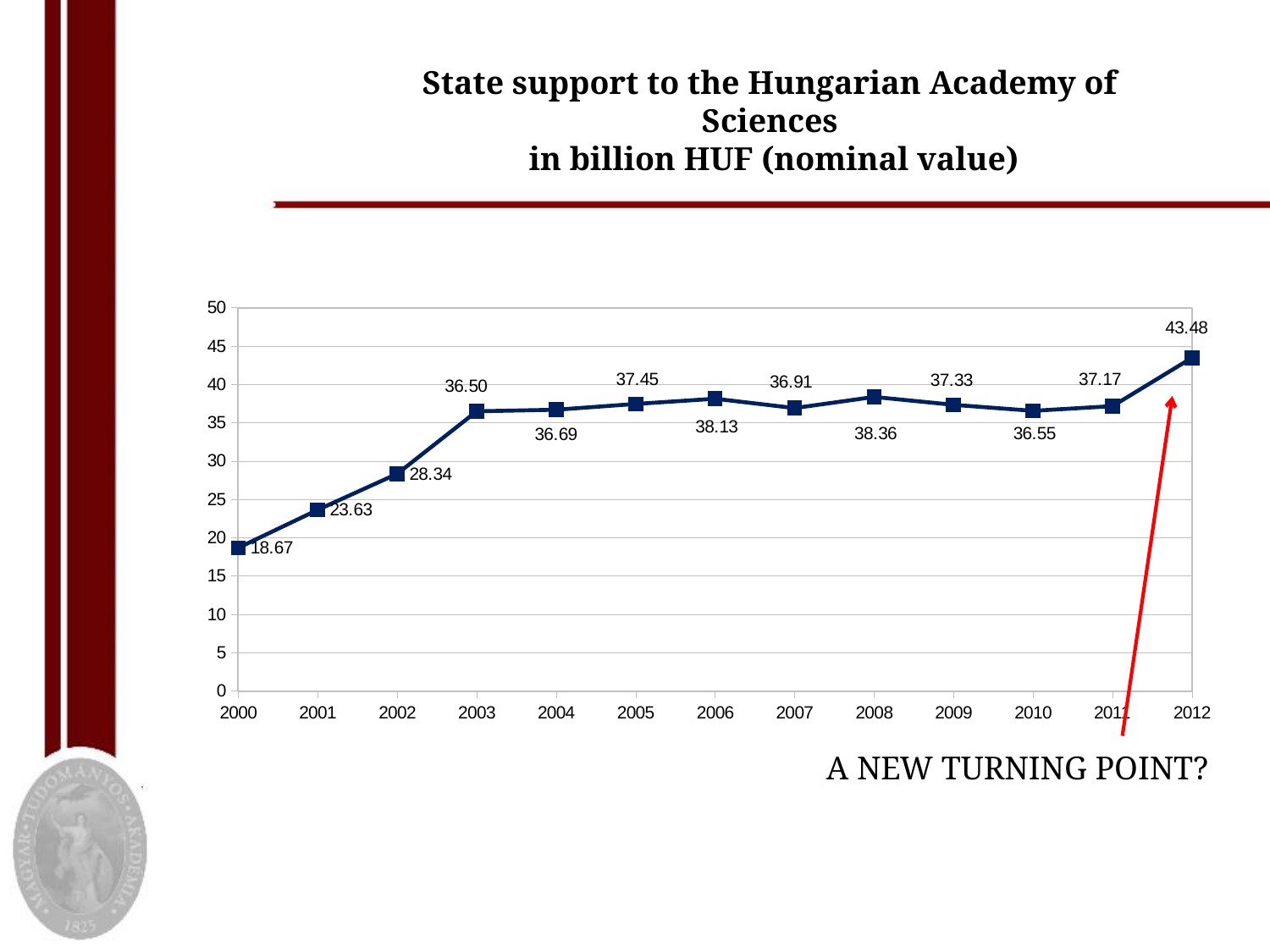
What is the value for 2000? 18.67 Is the value for 2002 greater or less than 30? less Which year has the lowest value? 2000 How many years are plotted on the chart? 13 What is the difference between the values for 2012 and 2011? 6.31 Do the values rise or fall from 2000 to 2003? rise What is the value for 2012? 43.48 Which year has the larger value, 2008 or 2006? 2008 What is the value for 2006? 38.13 Which year has the highest value? 2012 What kind of chart is shown on the slide? line chart What is the difference between the values for 2003 and 2002? 8.16